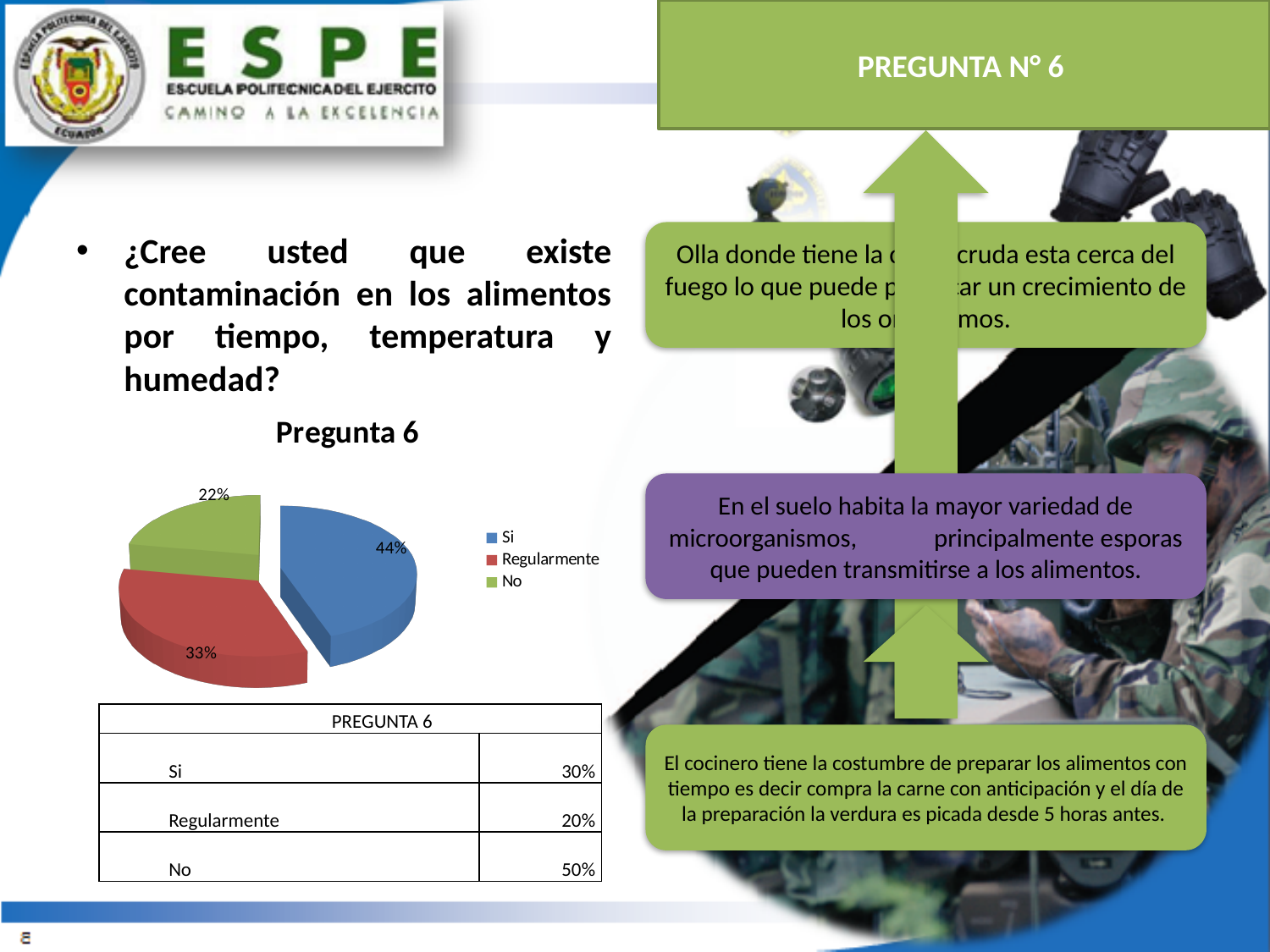
Which slice of the pie chart is the smallest? No What percentage is shown for the "Si" slice of the pie chart? 44% Which slice of the pie chart is the largest? Si How many slices does the pie chart have? 3 What percentage is shown for the "Regularmente" slice of the pie chart? 33% What percentage is shown for the "No" slice of the pie chart? 22% Which legend entry in the pie chart is shown in green? No In the pie chart, which is larger, the "Regularmente" slice or the "No" slice? Regularmente What is the title of the pie chart? Pregunta 6 What kind of chart is shown under the title "Pregunta 6"? pie chart What is the difference in percentage points between the "Si" slice and the "No" slice in the pie chart? 22 How many entries does the pie chart's legend list? 3